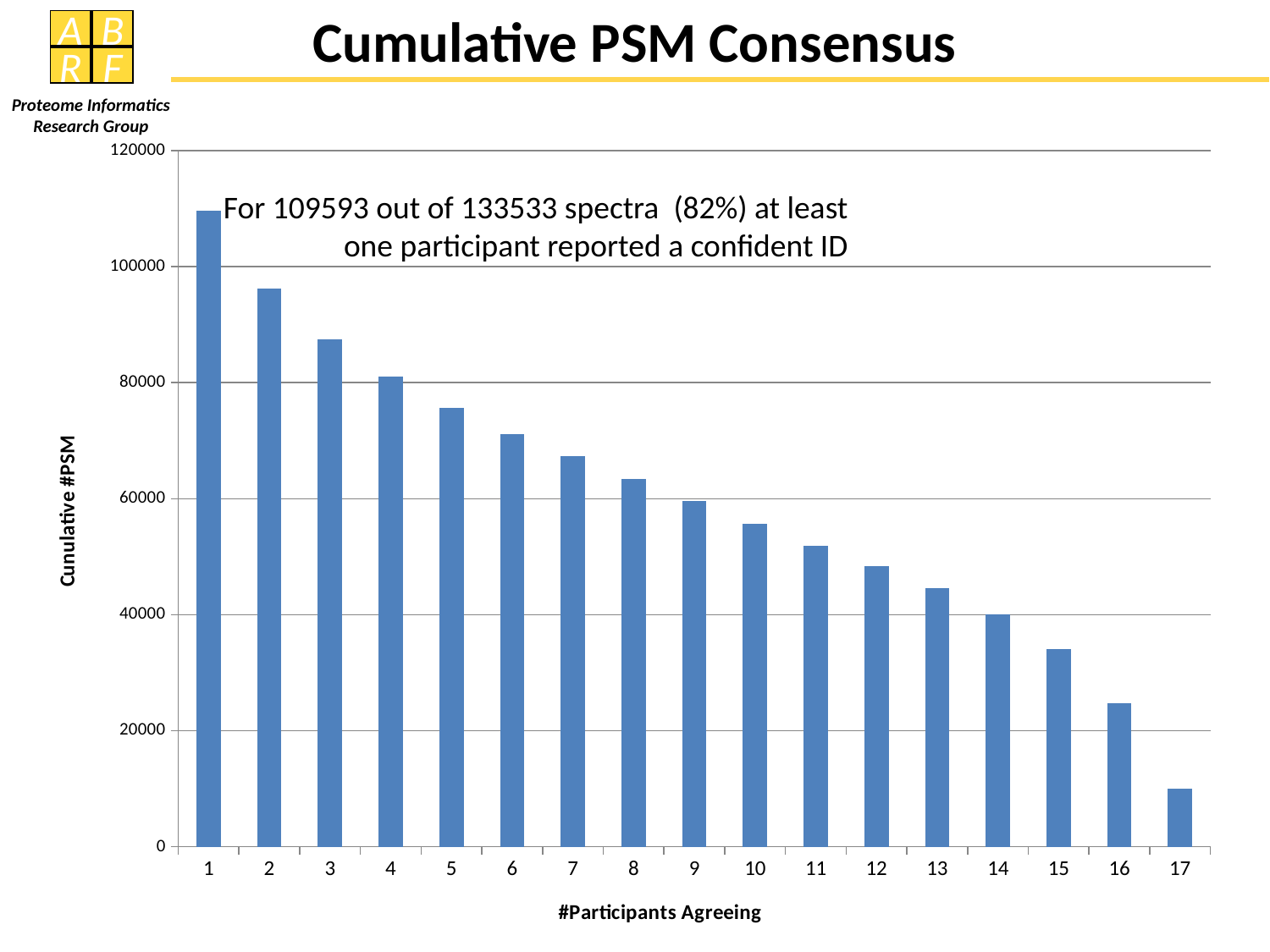
Which number of participants agreeing has the highest cumulative #PSM? 1 Is the cumulative #PSM for 17 participants agreeing greater or less than 20000? less What kind of chart is shown on the slide? bar chart Is the cumulative #PSM for 4 participants agreeing greater or less than 80000? greater According to the text on the chart, for how many spectra did at least one participant report a confident ID? 109593 What is the title of the chart's x axis? #Participants Agreeing How many categories are shown on the x axis of the chart? 17 Which has a larger cumulative #PSM: 5 participants agreeing or 10 participants agreeing? 5 Is the cumulative #PSM for 2 participants agreeing greater or less than 100000? less Which number of participants agreeing has the lowest cumulative #PSM? 17 Do the values rise or fall as the number of participants agreeing increases? fall